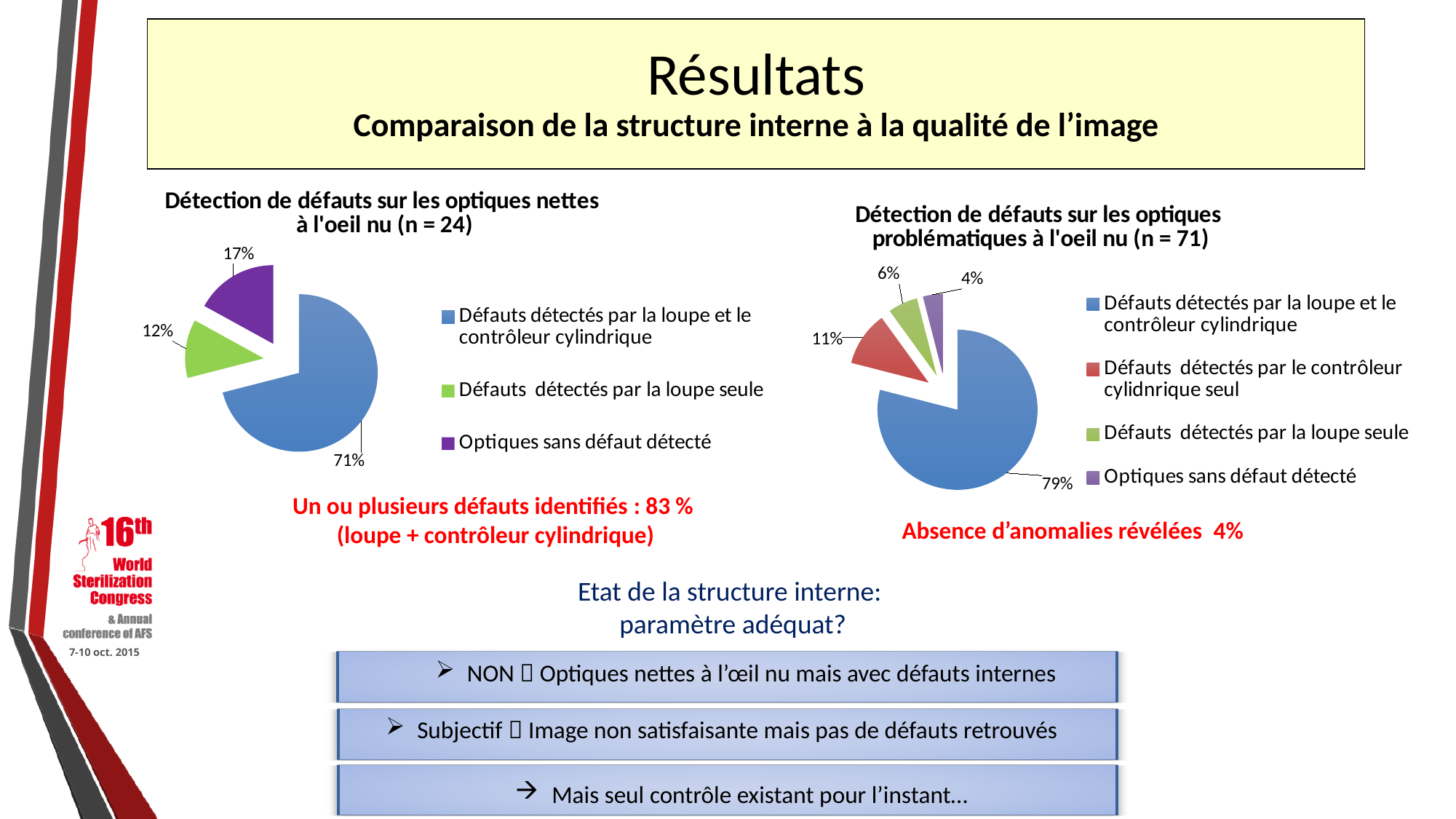
In the left pie chart (optiques nettes, n = 24), which category has the smallest slice? Défauts détectés par la loupe seule What type of chart is used for 'Détection de défauts sur les optiques nettes à l'oeil nu (n = 24)'? Pie chart In the right pie chart (optiques problématiques, n = 71), which category has the smallest slice? Optiques sans défaut détecté In the right pie chart (optiques problématiques, n = 71), which category has the largest slice? Défauts détectés par la loupe et le contrôleur cylindrique In the left pie chart (optiques nettes, n = 24), what share is labelled for 'Défauts détectés par la loupe seule'? 12% In the left pie chart (optiques nettes, n = 24), what share is labelled for 'Optiques sans défaut détecté'? 17% How many entries does the legend of the left pie chart (optiques nettes, n = 24) list? 3 In the right pie chart (optiques problématiques, n = 71), what share is labelled for 'Défauts détectés par le contrôleur cylindrique seul'? 11% In the left pie chart (optiques nettes, n = 24), what is the difference in percentage points between the 'loupe et contrôleur cylindrique' slice and the 'Optiques sans défaut détecté' slice? 54 In the left pie chart (optiques nettes, n = 24), what share is labelled for 'Défauts détectés par la loupe et le contrôleur cylindrique'? 71% In the right pie chart (optiques problématiques, n = 71), what share is labelled for 'Optiques sans défaut détecté'? 4% How many slices does the right pie chart (optiques problématiques, n = 71) have? 4